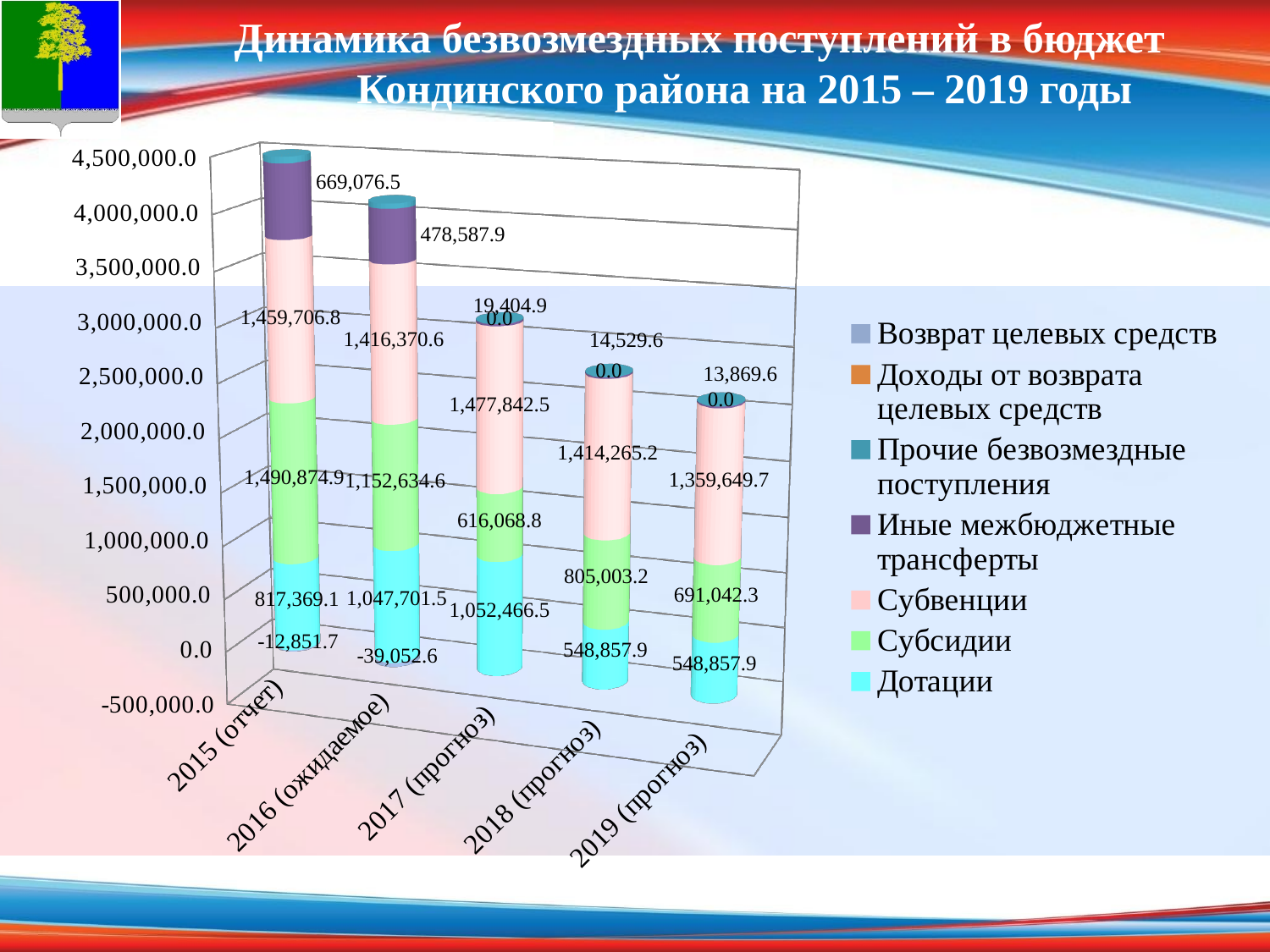
How many year categories are shown on the x axis of the chart? 5 In which year is the value of Субсидии the lowest? 2017 (прогноз) In which year is the value of Субсидии the highest? 2015 (отчет) What kind of chart is shown on the slide? Stacked bar chart Does the overall height of the stacked bars rise or fall from 2015 to 2019? Fall How many series does the chart legend list? 7 What is the value of Субвенции for 2017 (прогноз)? 1,477,842.5 Which year has the larger value of Субвенции: 2015 (отчет) or 2016 (ожидаемое)? 2015 (отчет) What is the value of Субсидии for 2019 (прогноз)? 691,042.3 What is the value of Иные межбюджетные трансферты for 2016 (ожидаемое)? 478,587.9 By how much does Дотации in 2016 (ожидаемое) exceed Дотации in 2015 (отчет)? 230,332.4 What is the value of Дотации for 2015 (отчет)? 817,369.1